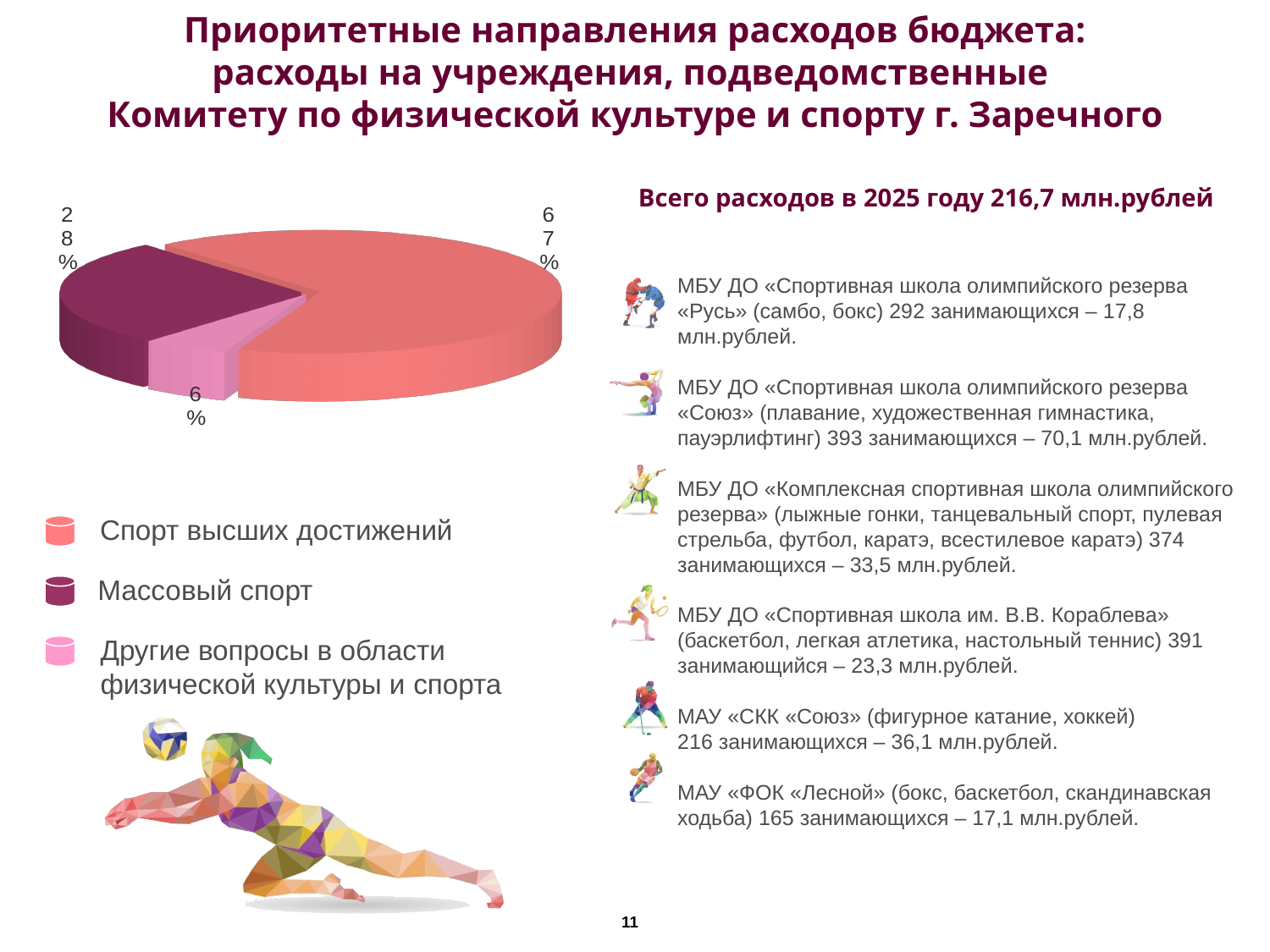
What is the difference in percentage points between «Массовый спорт» and «Другие вопросы в области физической культуры и спорта»? 22 How many slices does the pie chart have? 3 How many entries does the legend of the pie chart list? 3 What share of the pie does «Спорт высших достижений» have? 67% What colour is the slice for «Массовый спорт» in the pie chart? Dark magenta Which category has the smallest slice of the pie? Другие вопросы в области физической культуры и спорта What is the difference in percentage points between «Спорт высших достижений» and «Массовый спорт»? 39 Which category has the largest slice of the pie? Спорт высших достижений Which is larger: the slice for «Массовый спорт» or the slice for «Другие вопросы в области физической культуры и спорта»? Массовый спорт What share of the pie does «Другие вопросы в области физической культуры и спорта» have? 6% What share of the pie does «Массовый спорт» have? 28% What kind of chart is shown on the slide? Pie chart